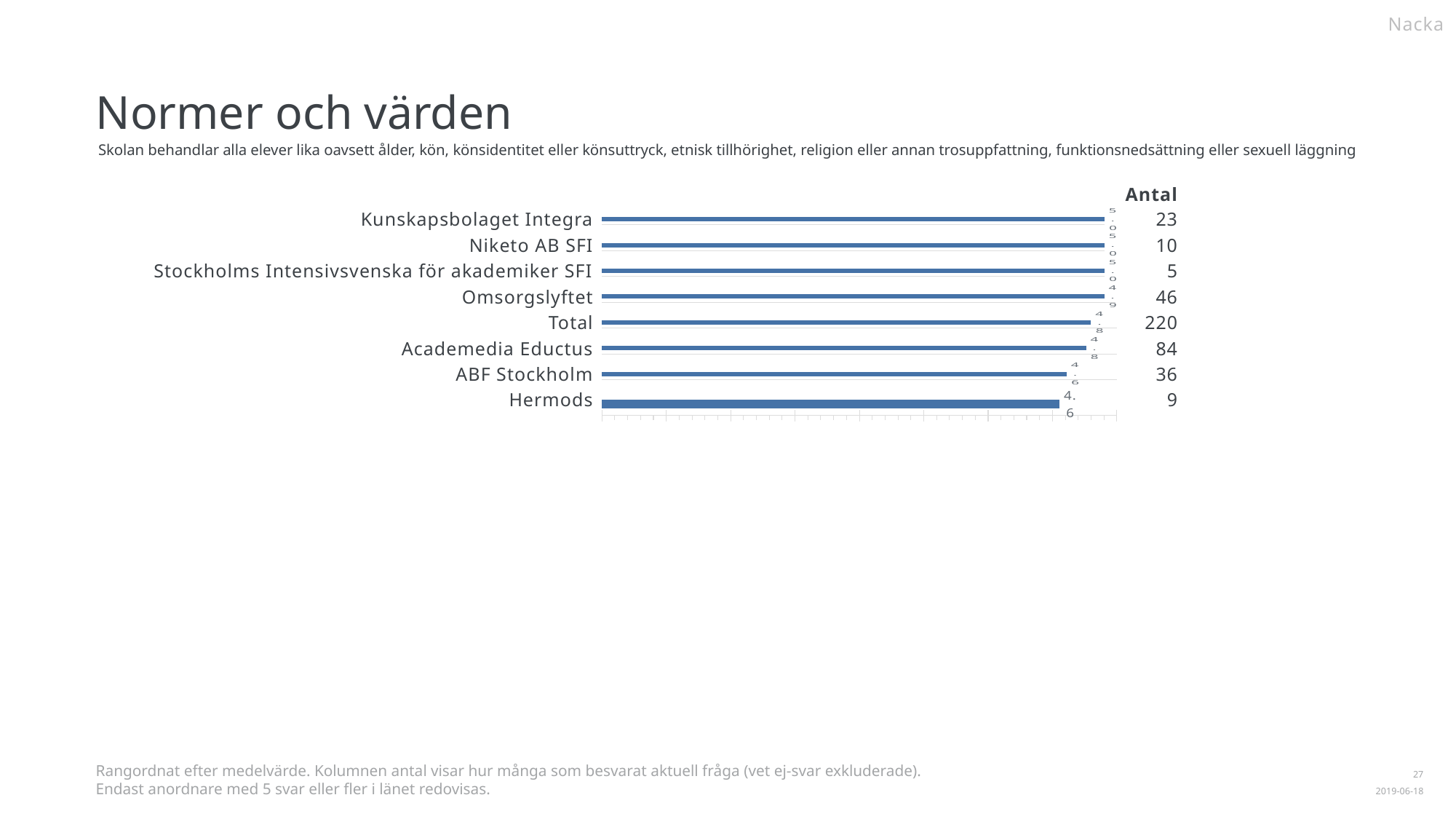
What is the Antal value for Academedia Eductus? 84 What is the difference in Antal between Academedia Eductus and ABF Stockholm? 48 Which has the longer bar, Kunskapsbolaget Integra or Hermods? Kunskapsbolaget Integra What is the Antal value for Omsorgslyftet? 46 What is the Antal value for Hermods? 9 What kind of chart is shown on the slide? Bar chart What is the heading of the number column to the right of the bars? Antal What is the Antal value for Total? 220 Which category is listed at the top of the chart? Kunskapsbolaget Integra Which category has the lowest Antal value? Stockholms Intensivsvenska för akademiker SFI Excluding Total, which category has the highest Antal value? Academedia Eductus How many categories (providers, including Total) are plotted in the chart? 8